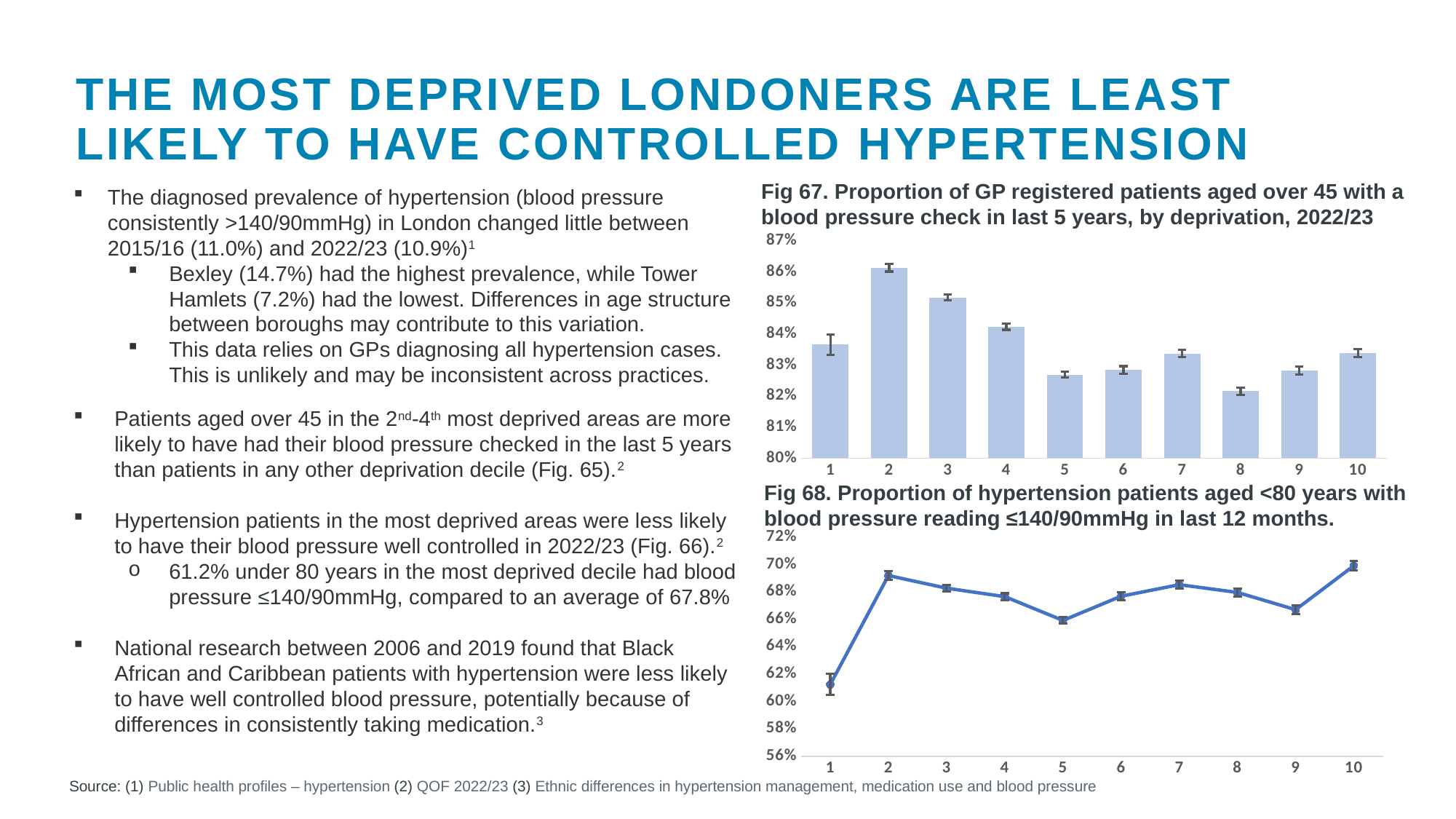
What kind of chart is Fig 67? Bar chart In Fig 67, which deprivation decile has the lowest proportion of patients with a blood pressure check? 8 In Fig 67, which deprivation decile has the highest proportion of patients with a blood pressure check? 2 What kind of chart is Fig 68? Line chart In Fig 68, which deprivation decile has the lowest proportion of patients with blood pressure ≤140/90mmHg? 1 In Fig 67, is the value for decile 8 greater or less than 83%? less In Fig 67, is the value for decile 2 greater or less than 85%? greater In Fig 68, is the value for decile 1 greater or less than 62%? less In Fig 67, which has the larger value, decile 2 or decile 8? Decile 2 How many deprivation deciles are plotted in Fig 67? 10 In Fig 68, which has the larger value, decile 1 or decile 5? Decile 5